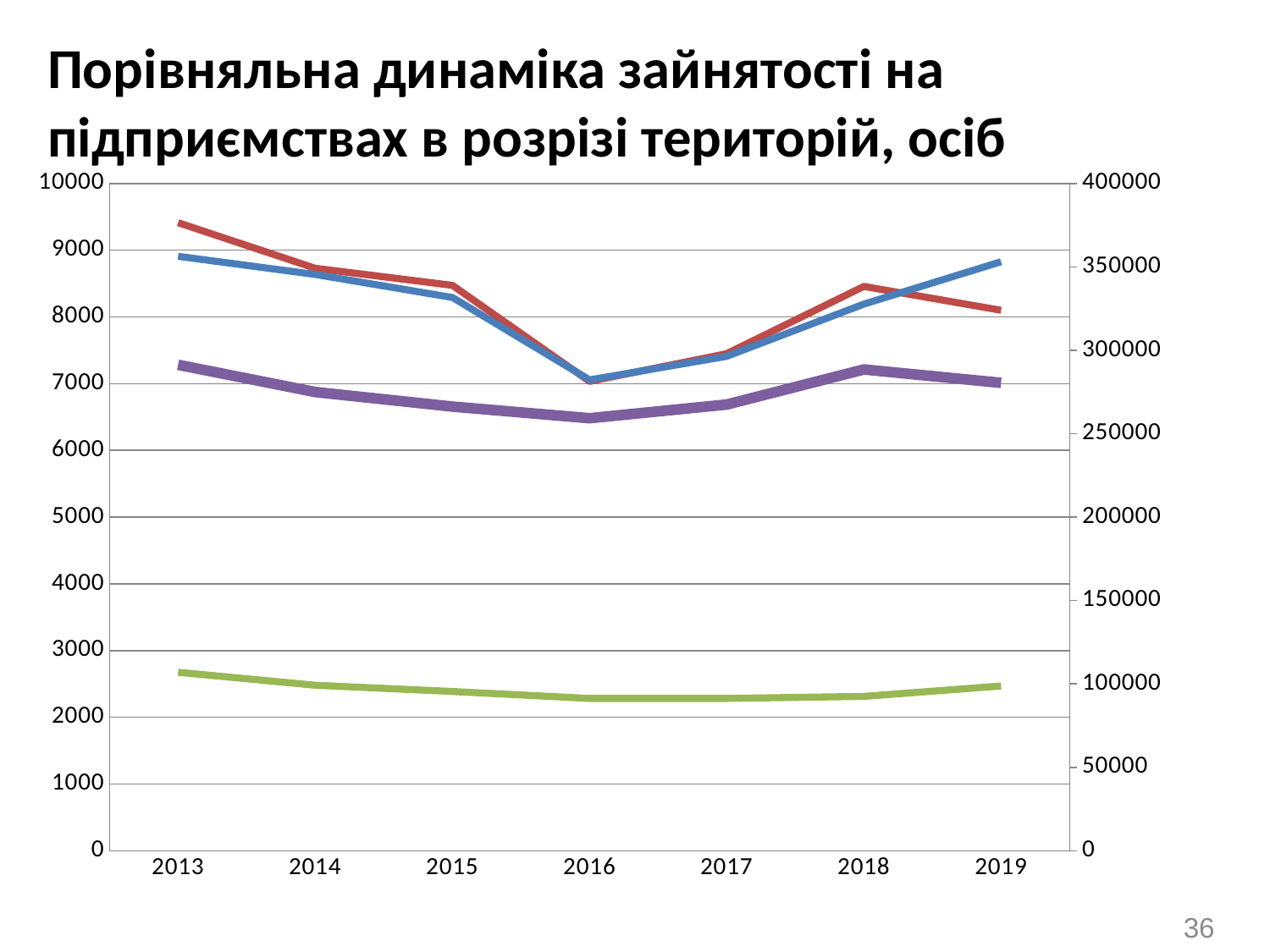
In 2019, which line is higher, the blue line or the red line? blue line What is the highest value shown on the right-hand y axis? 400000 How many years are shown along the x axis of the chart? 7 What is the first year shown on the x axis? 2013 In which year does the green line reach its highest point? 2013 How many lines are plotted on the chart? 4 In 2013, which line is higher, the blue line or the red line? red line What kind of chart is shown on the slide? line chart In which year does the red line reach its highest point? 2013 Does the blue line rise or fall between 2016 and 2019? rise In which year does the blue line reach its lowest point? 2016 In which year does the purple line reach its lowest point? 2016